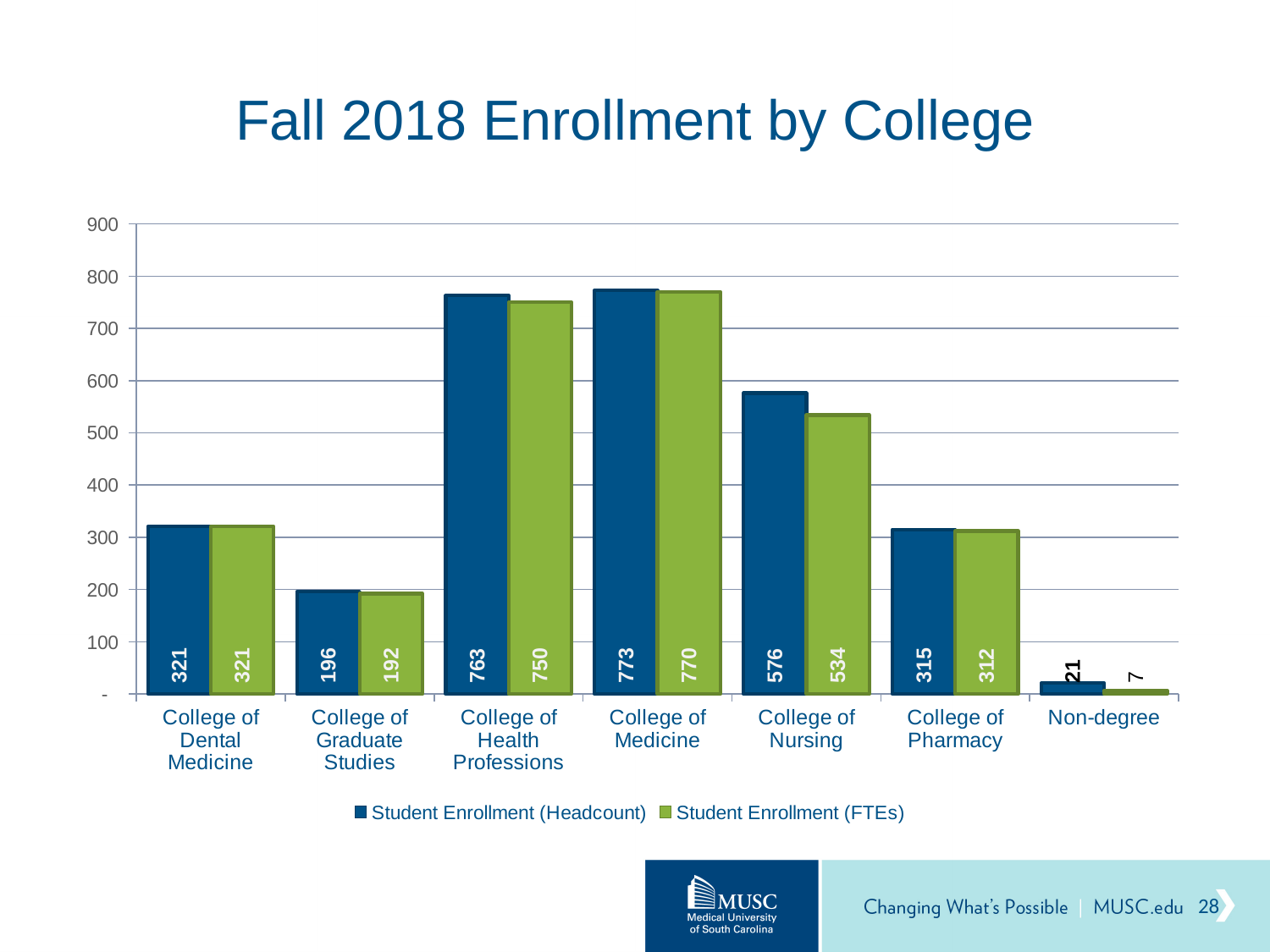
How many series does the legend list? 2 What is the Student Enrollment (Headcount) for Non-degree? 21 What is the title of the chart? Fall 2018 Enrollment by College Which college has the highest Student Enrollment (Headcount)? College of Medicine What kind of chart is shown on the slide? bar chart What is the Student Enrollment (FTEs) for the College of Nursing? 534 How many categories are shown on the x axis? 7 What is the difference between the Headcount and FTEs for the College of Nursing? 42 Which category has the lowest Student Enrollment (FTEs)? Non-degree Is the Student Enrollment (FTEs) for the College of Pharmacy greater or less than 400? less Which is larger: the Headcount for the College of Health Professions or the Headcount for the College of Nursing? College of Health Professions What is the Student Enrollment (Headcount) for the College of Medicine? 773